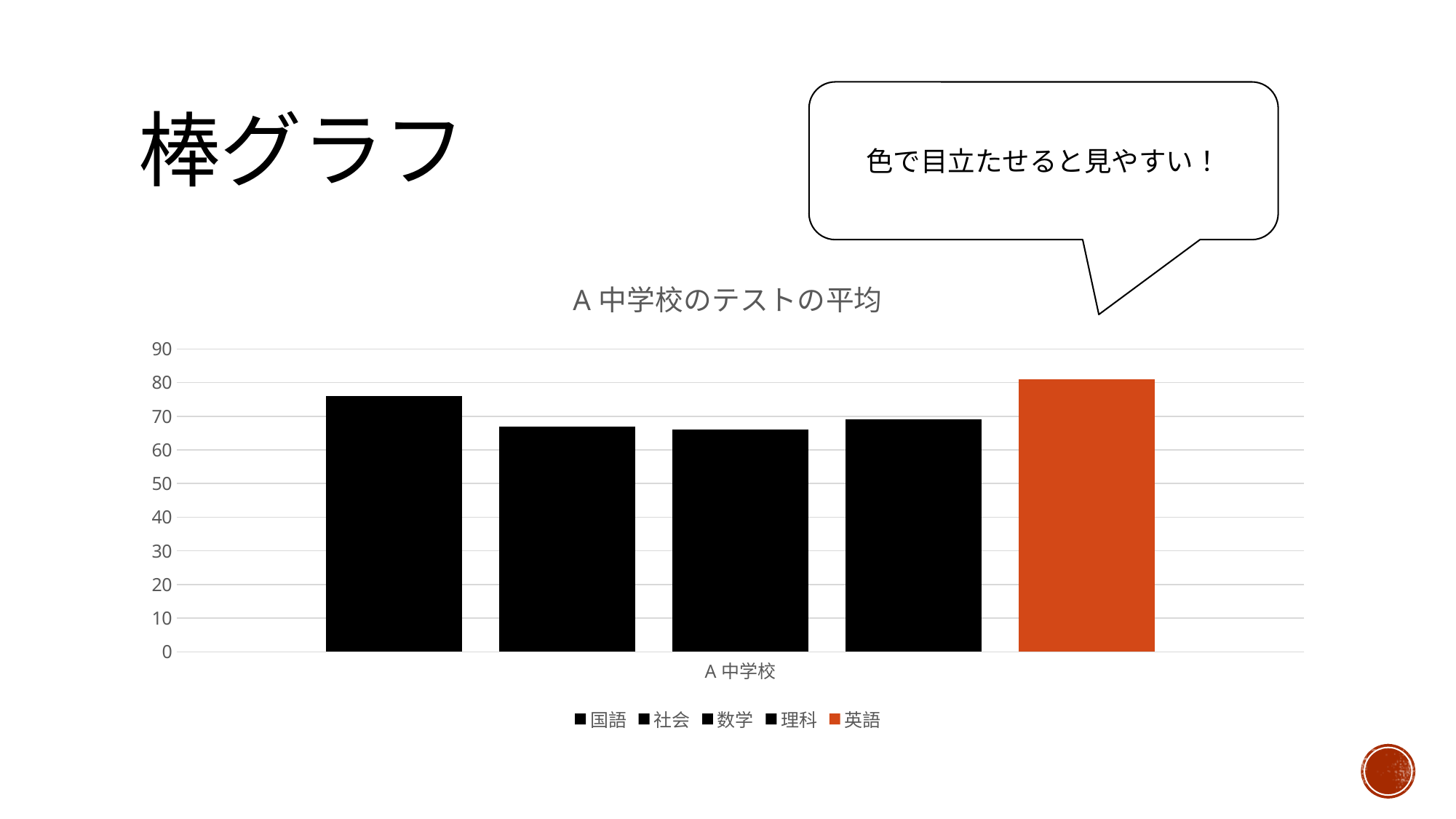
Is the value for 社会 greater or less than 70? less What is the title of the chart? A 中学校のテストの平均 Which is larger, the value for 理科 or the value for 英語? 英語 Is the value for 英語 greater or less than 70? greater Which series is drawn in orange rather than black? 英語 Which series has the highest bar? 英語 How many categories are shown on the x axis? 1 Is the value for 数学 greater or less than 70? less What kind of chart is shown on the slide? bar chart Which is larger, the value for 国語 or the value for 社会? 国語 How many series does the legend list? 5